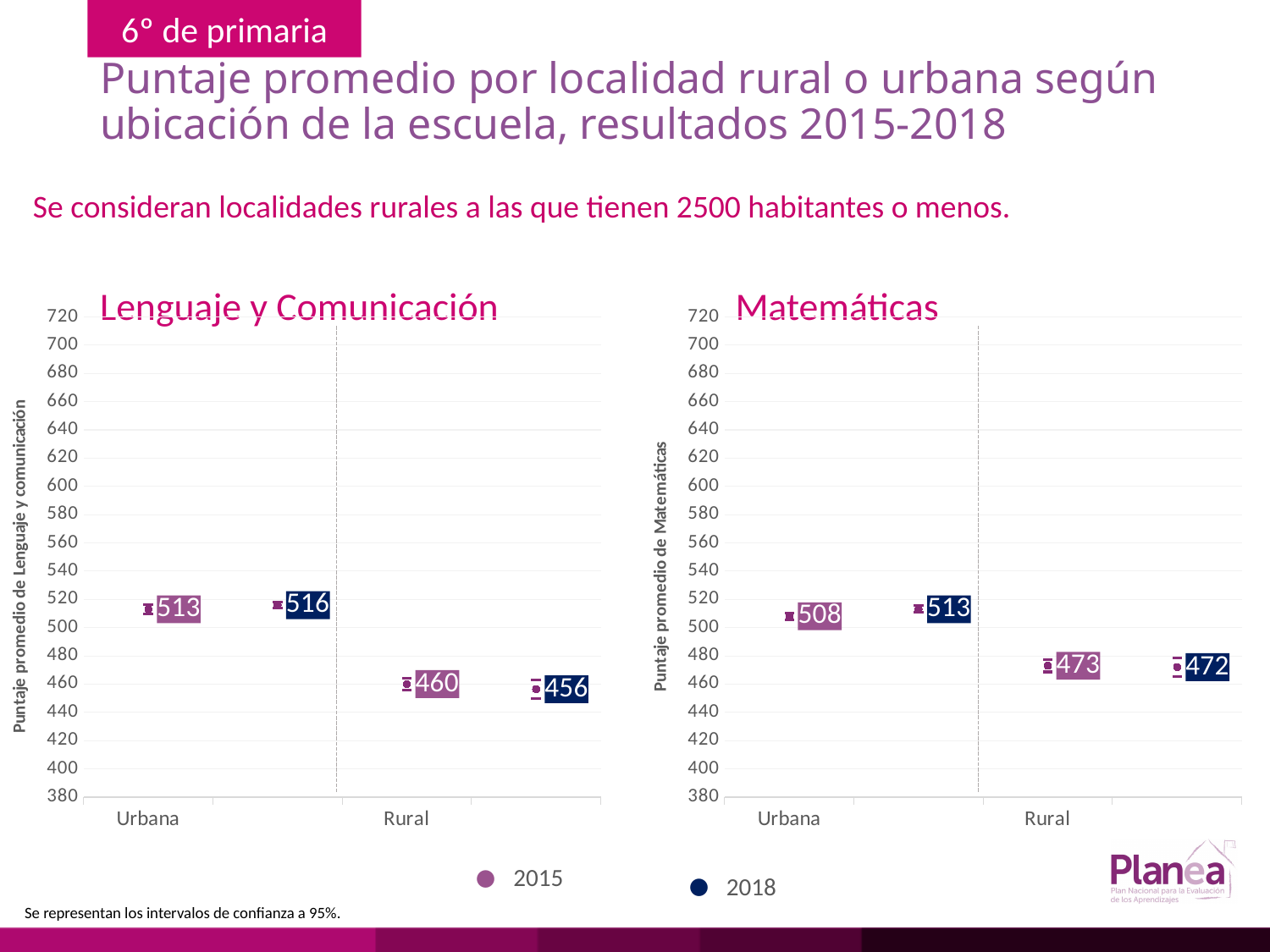
In the Lenguaje y Comunicación chart, which is larger for Rural: the 2015 value or the 2018 value? 2015 In the Matemáticas chart, what is the 2015 value for Urbana? 508 In the Lenguaje y Comunicación chart, what is the 2015 value for Urbana? 513 In the Lenguaje y Comunicación chart, which point has the highest value? Urbana 2018 (516) In the Matemáticas chart, what is the difference between the 2015 Urbana value and the 2015 Rural value? 35 In the Matemáticas chart, which point has the lowest value? Rural 2018 (472) What is the title of the chart on the right? Matemáticas In the Lenguaje y Comunicación chart, what is the difference between the 2018 Urbana value and the 2018 Rural value? 60 In the Matemáticas chart, what is the 2018 value for Rural? 472 How many series does the legend list? 2 In the Lenguaje y Comunicación chart, what is the 2018 value for Rural? 456 In the Matemáticas chart, which is larger for Urbana: the 2015 value or the 2018 value? 2018